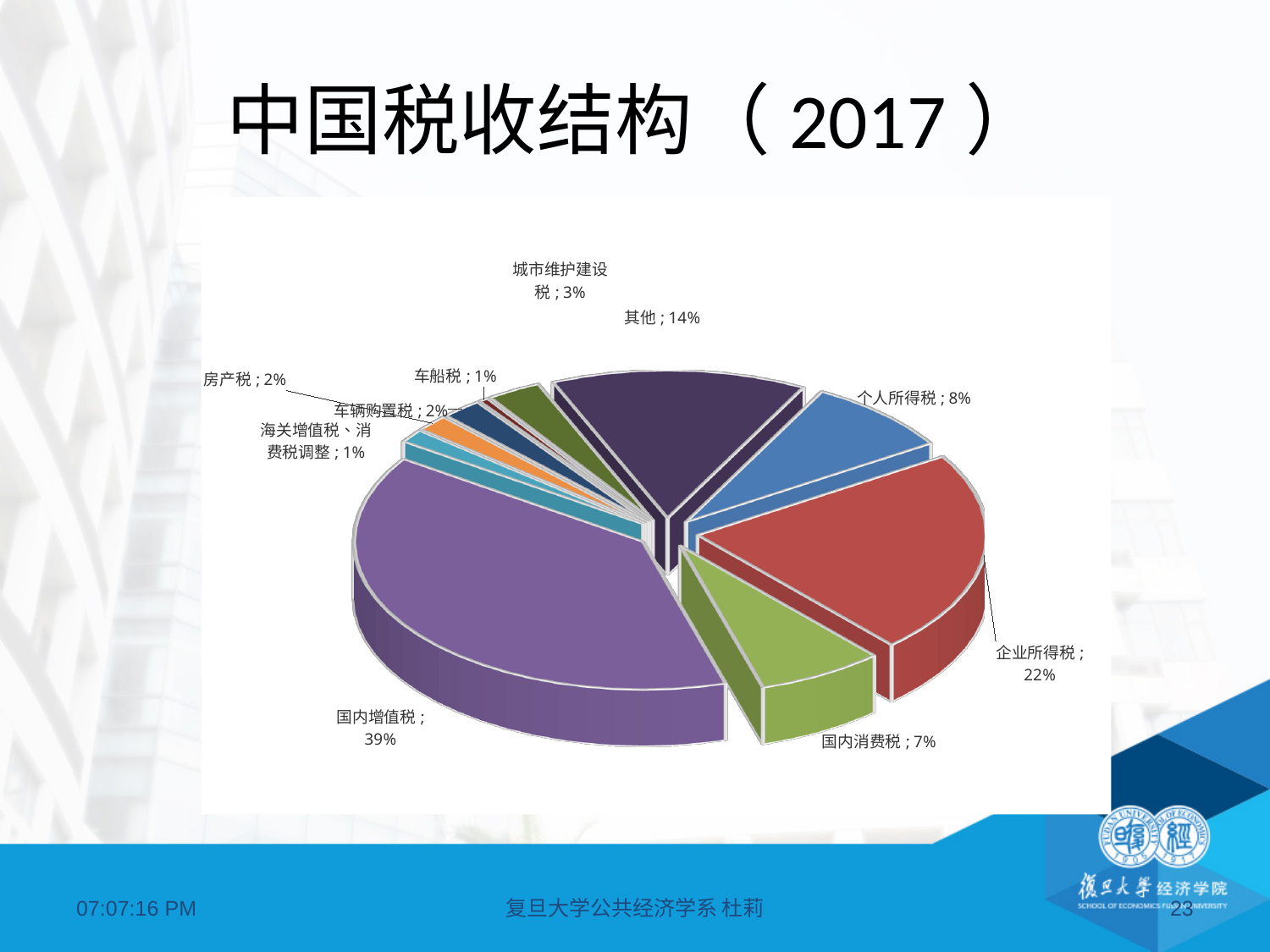
How many slices does the pie chart have? 10 What is the value shown for 个人所得税? 8% Which category has the largest slice of the pie? 国内增值税 What kind of chart is shown on the slide? pie chart Which is larger, 企业所得税 or 个人所得税? 企业所得税 What share of the pie does 国内增值税 have? 39% What share of the pie does 企业所得税 have? 22% What is the value shown for 国内消费税? 7% What is the value shown for 城市维护建设税? 3% What is the title of the slide containing the chart? 中国税收结构（2017） What is the difference between the shares of 国内增值税 and 企业所得税? 17% What is the value shown for 其他? 14%